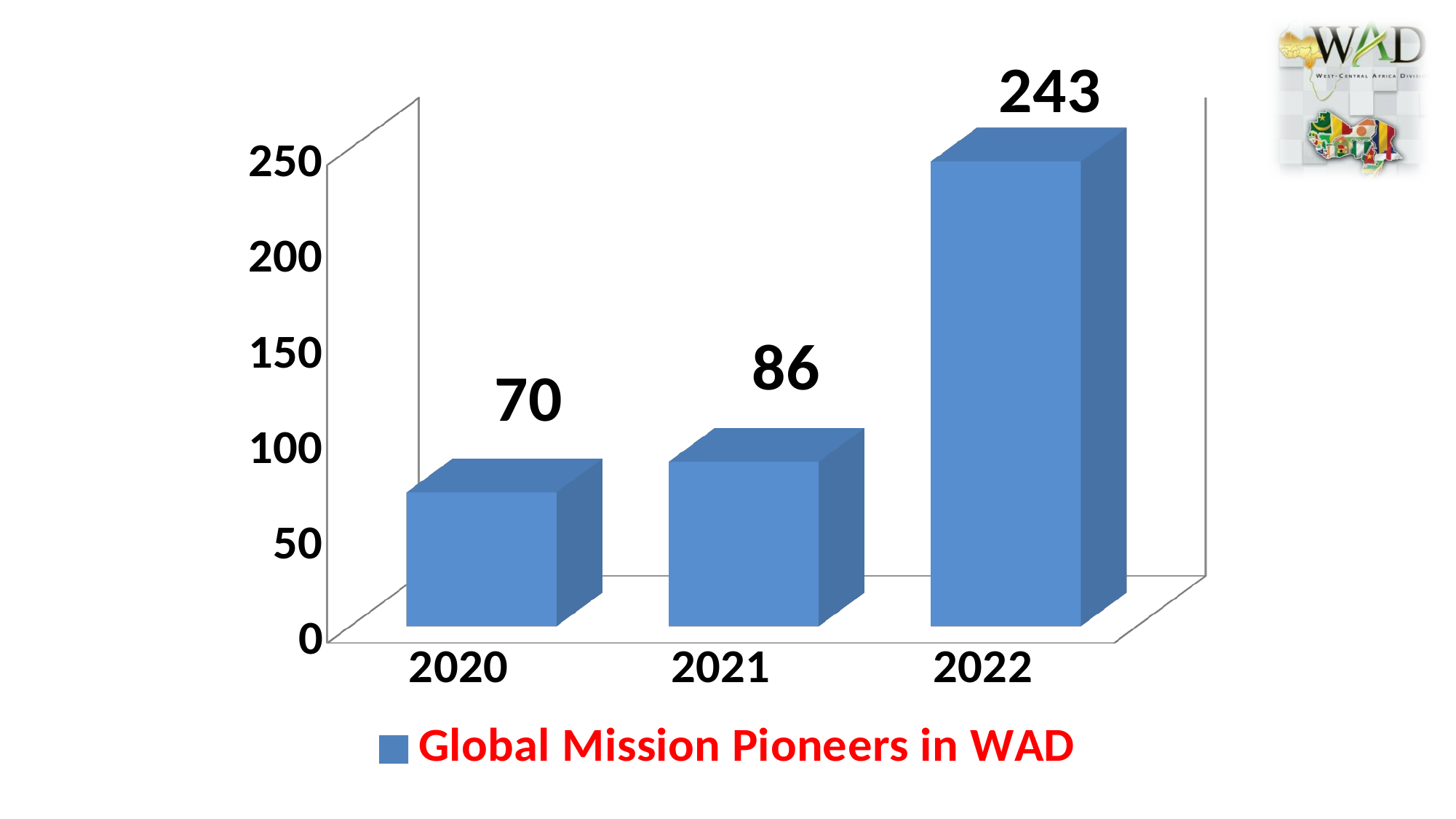
Which year has the lowest value? 2020 What is the value for 2022? 243 What is the value for 2020? 70 How many years are shown on the x axis? 3 Do the values rise or fall from 2020 to 2022? rise Which year has the highest value? 2022 What kind of chart is shown? bar chart What is the difference between the values for 2021 and 2020? 16 Is the value for 2022 greater or less than 200? greater What is the difference between the values for 2022 and 2021? 157 Which is larger, the value for 2020 or the value for 2021? 2021 What is the value for 2021? 86